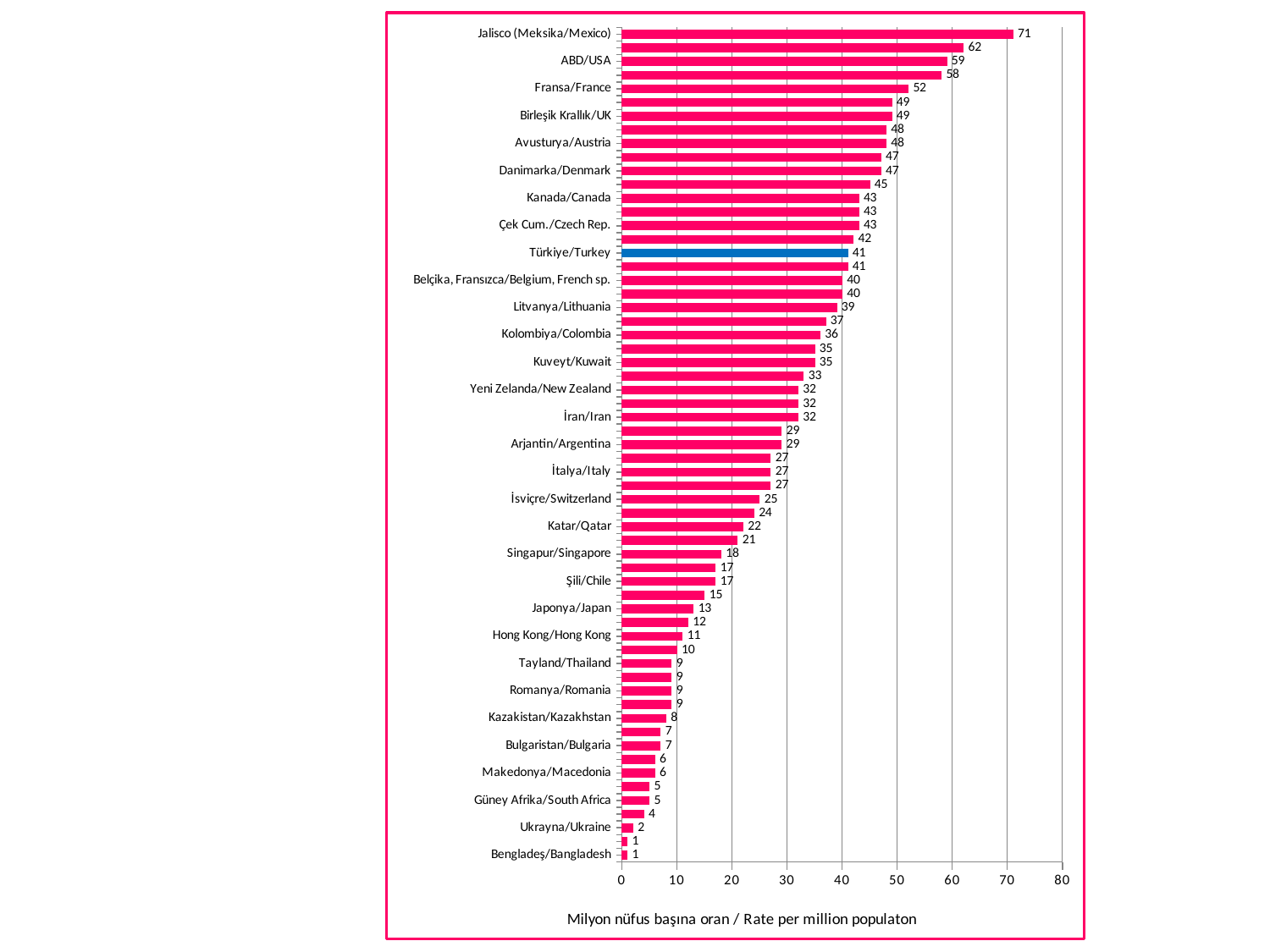
Which category has the highest value? Jalisco (Meksika/Mexico) What is the value for Türkiye/Turkey? 41 Which is larger, the value for Kanada/Canada or the value for Kuveyt/Kuwait? Kanada/Canada What is the value for Japonya/Japan? 13 What kind of chart is shown on the slide? Bar chart What is the difference between the values for Türkiye/Turkey and Singapur/Singapore? 23 What is the value for Jalisco (Meksika/Mexico)? 71 Which category's bar is coloured blue instead of pink? Türkiye/Turkey What is the value for Kuveyt/Kuwait? 35 What is the title of the horizontal axis? Milyon nüfus başına oran / Rate per million populaton What is the difference between the values for ABD/USA and Fransa/France? 7 Is the value for Birleşik Krallık/UK greater or less than 40? greater